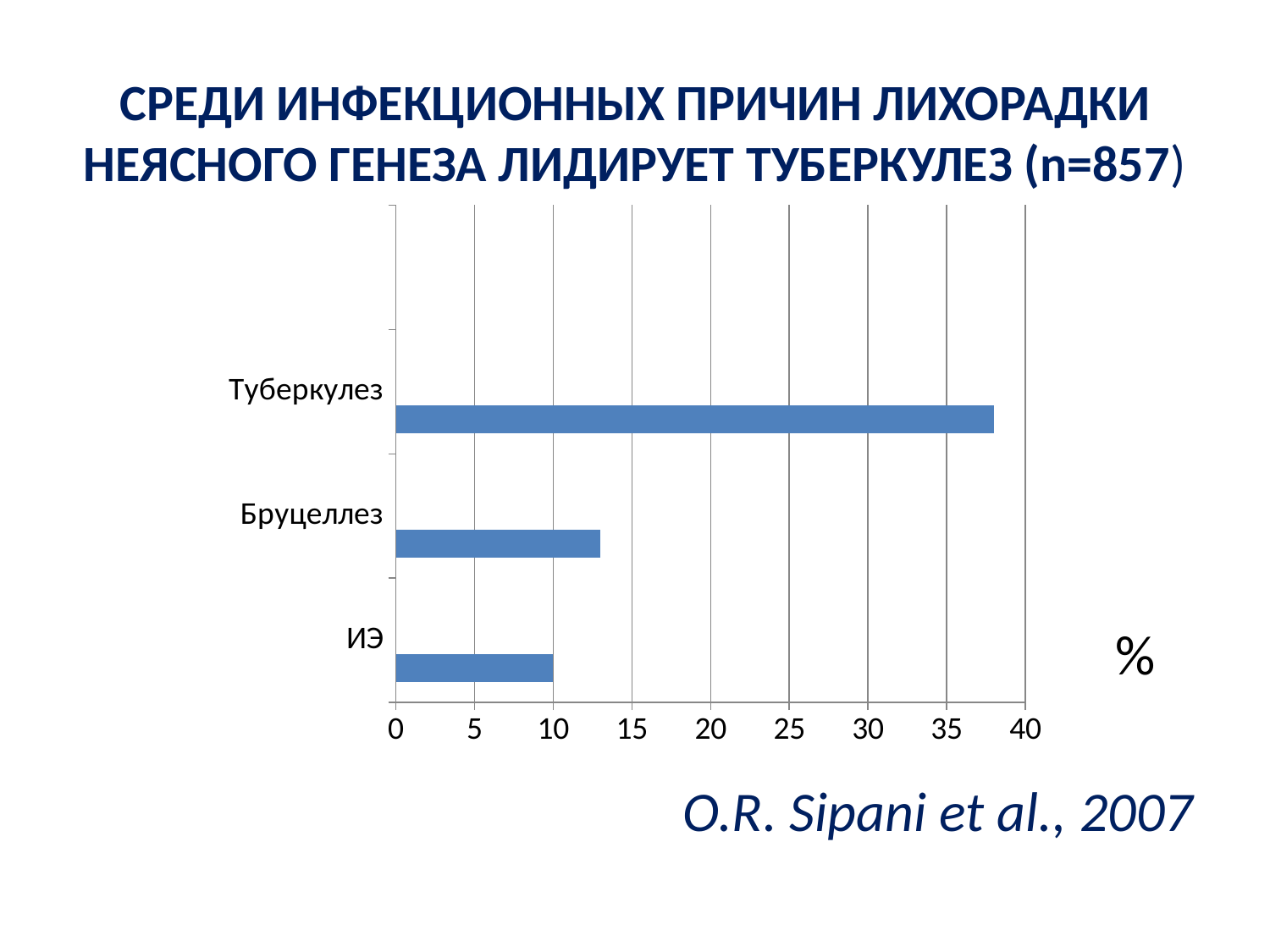
Which category has the lowest value? ИЭ Is the value for Туберкулез greater or less than 35? greater Which is larger, the value for Бруцеллез or the value for ИЭ? Бруцеллез What is the value for ИЭ? 10 What is the sample size (n) stated in the slide title? 857 What unit is indicated for the horizontal axis of the chart? % Is the value for Бруцеллез greater or less than 15? less What kind of chart is shown on the slide? bar chart Which category has the highest value? Туберкулез Is the value for Бруцеллез greater or less than 10? greater Which is larger, the value for Туберкулез or the value for Бруцеллез? Туберкулез How many categories are plotted in the chart? 3